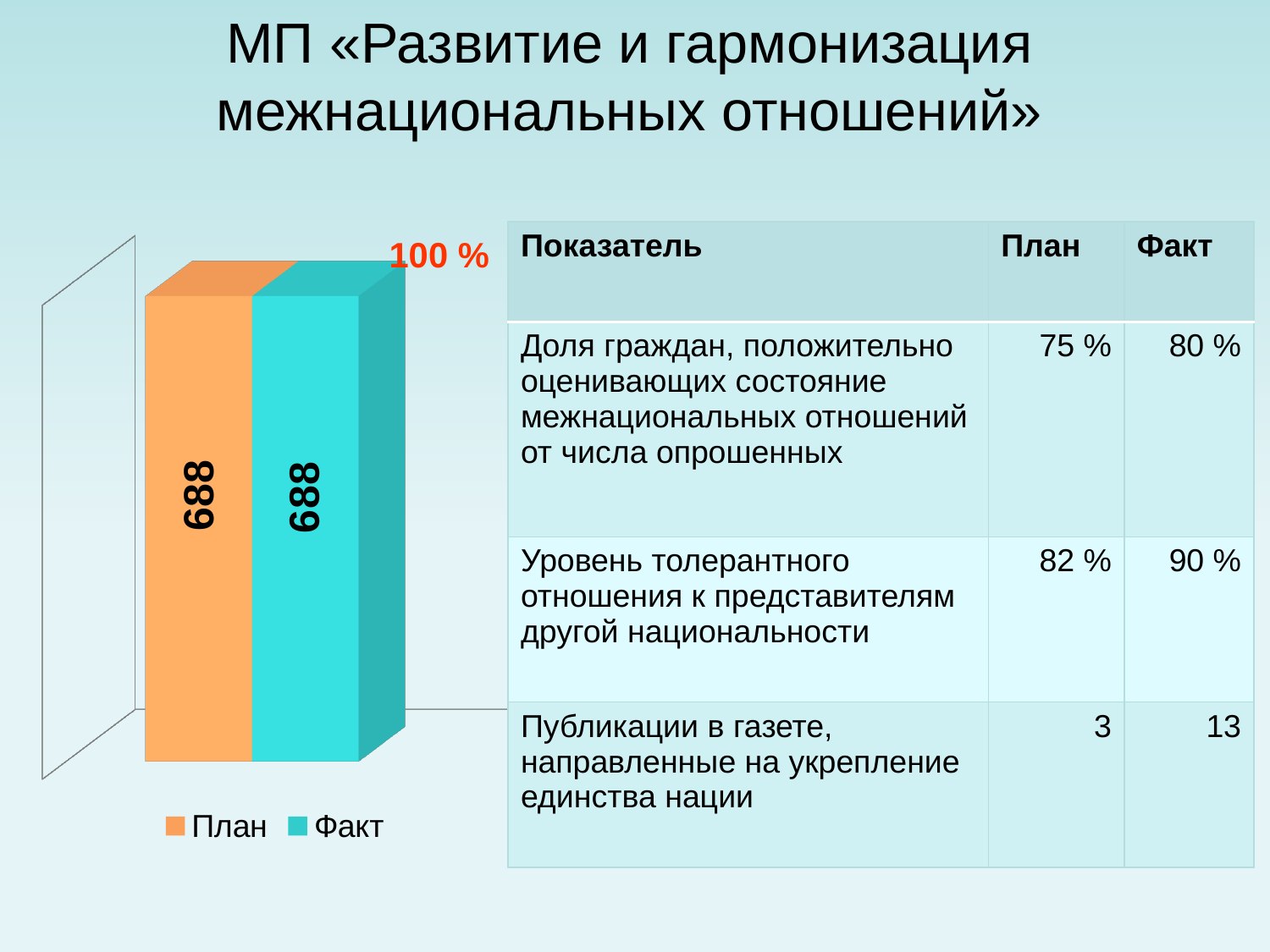
What is the difference between the Факт value and the План value in the chart? 0 What value is shown on the Факт bar in the chart? 688 What value is shown on the План bar in the chart? 688 What kind of chart is shown on the slide? bar chart How many bars are plotted in the chart? 2 What percentage label is printed in red above the bars in the chart? 100 % Which colour represents План in the chart legend? orange How many series does the chart legend list? 2